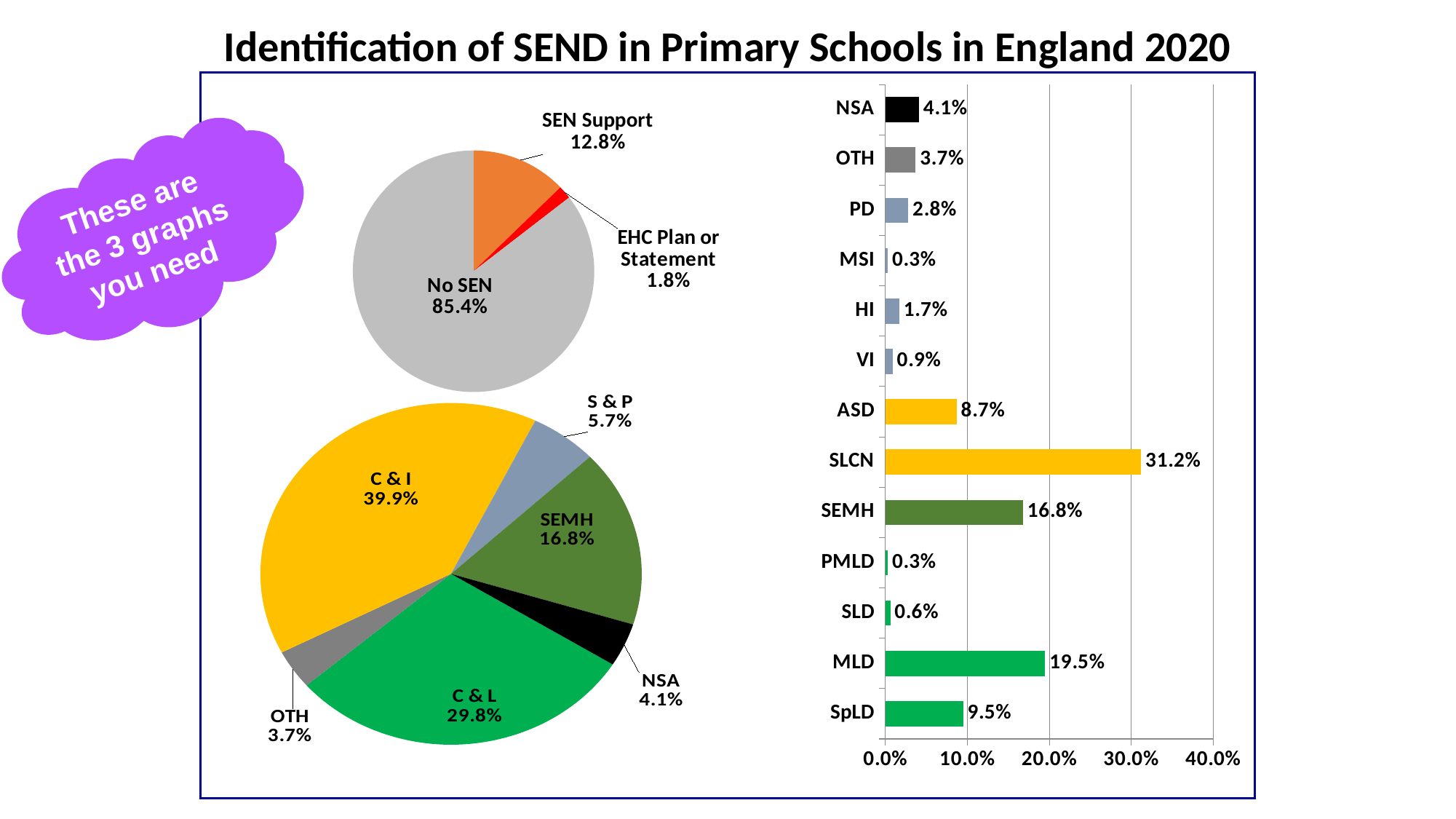
In the bar chart on the right, what is the value for MLD? 19.5% In the bottom-left pie chart, what share is labelled for SEMH? 16.8% In the bar chart on the right, which is larger, the value for ASD or the value for SpLD? SpLD In the bar chart on the right, which category has the highest value? SLCN In the bottom-left pie chart, which category has the smallest slice? OTH What kind of chart is the chart on the right of the slide? Bar chart In the bottom-left pie chart, which category has the largest slice? C & I In the bar chart on the right, how many categories are shown? 13 In the top-left pie chart, how many slices are there? 3 In the bottom-left pie chart, what is the difference between the C & I share and the C & L share? 10.1% In the top-left pie chart, what share is labelled for No SEN? 85.4% In the top-left pie chart, what share is labelled for EHC Plan or Statement? 1.8%